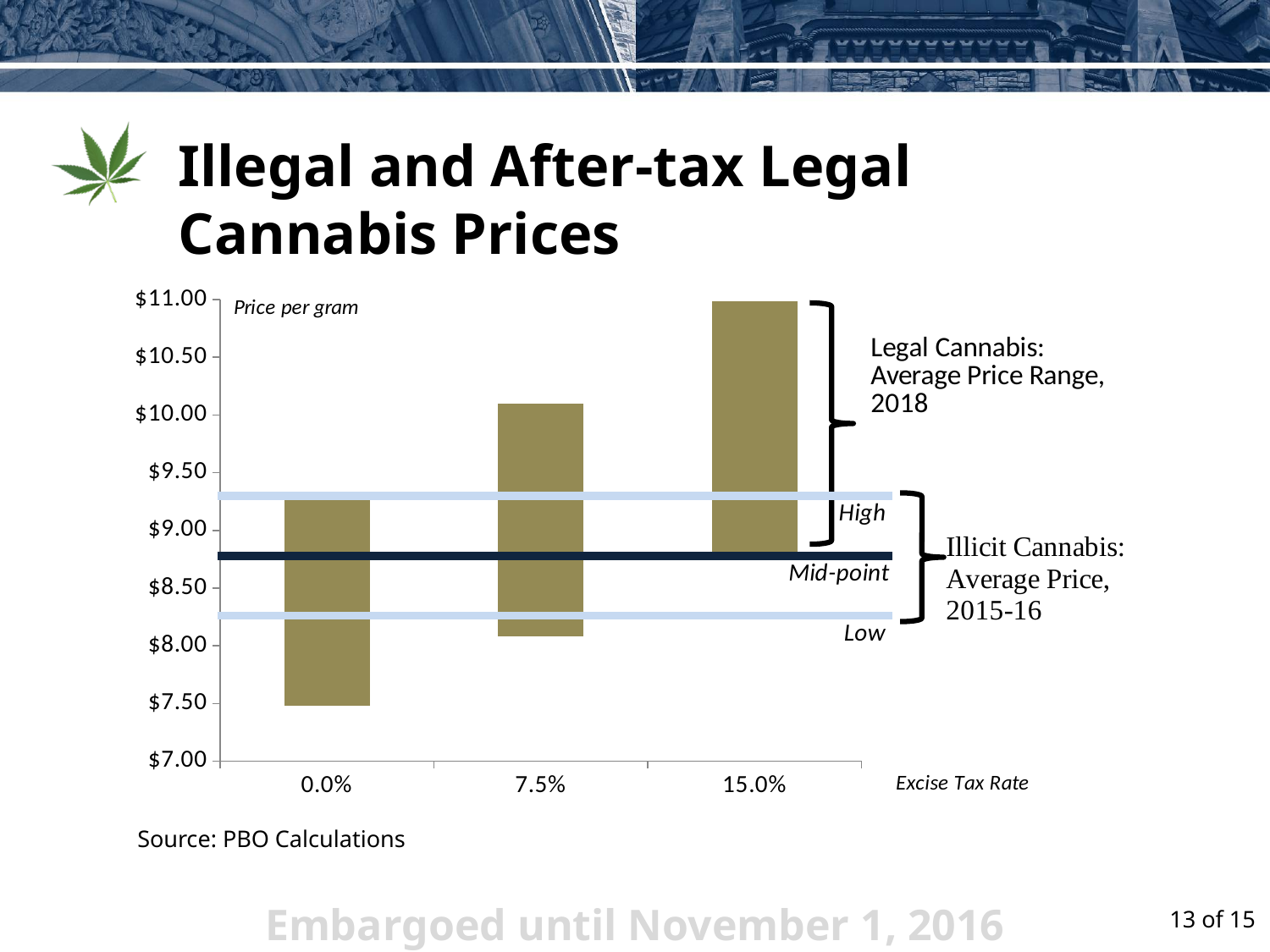
Which excise tax rate has the lowest bottom of its legal cannabis price range? 0.0% Is the bottom of the price range bar for the 0.0% excise tax rate greater or less than $8.00? less What kind of chart is shown on the slide? bar chart Is the top of the price range bar for the 15.0% excise tax rate greater or less than $10.50? greater Do the legal cannabis price ranges rise or fall as the excise tax rate increases along the x axis? rise Is the top of the price range bar for the 0.0% excise tax rate greater or less than $9.50? less What is the title of the chart on the slide? Illegal and After-tax Legal Cannabis Prices Which excise tax rate has the highest top of its legal cannabis price range? 15.0% How many excise tax rate categories are shown on the x axis? 3 What is the label on the x axis of the chart? Excise Tax Rate